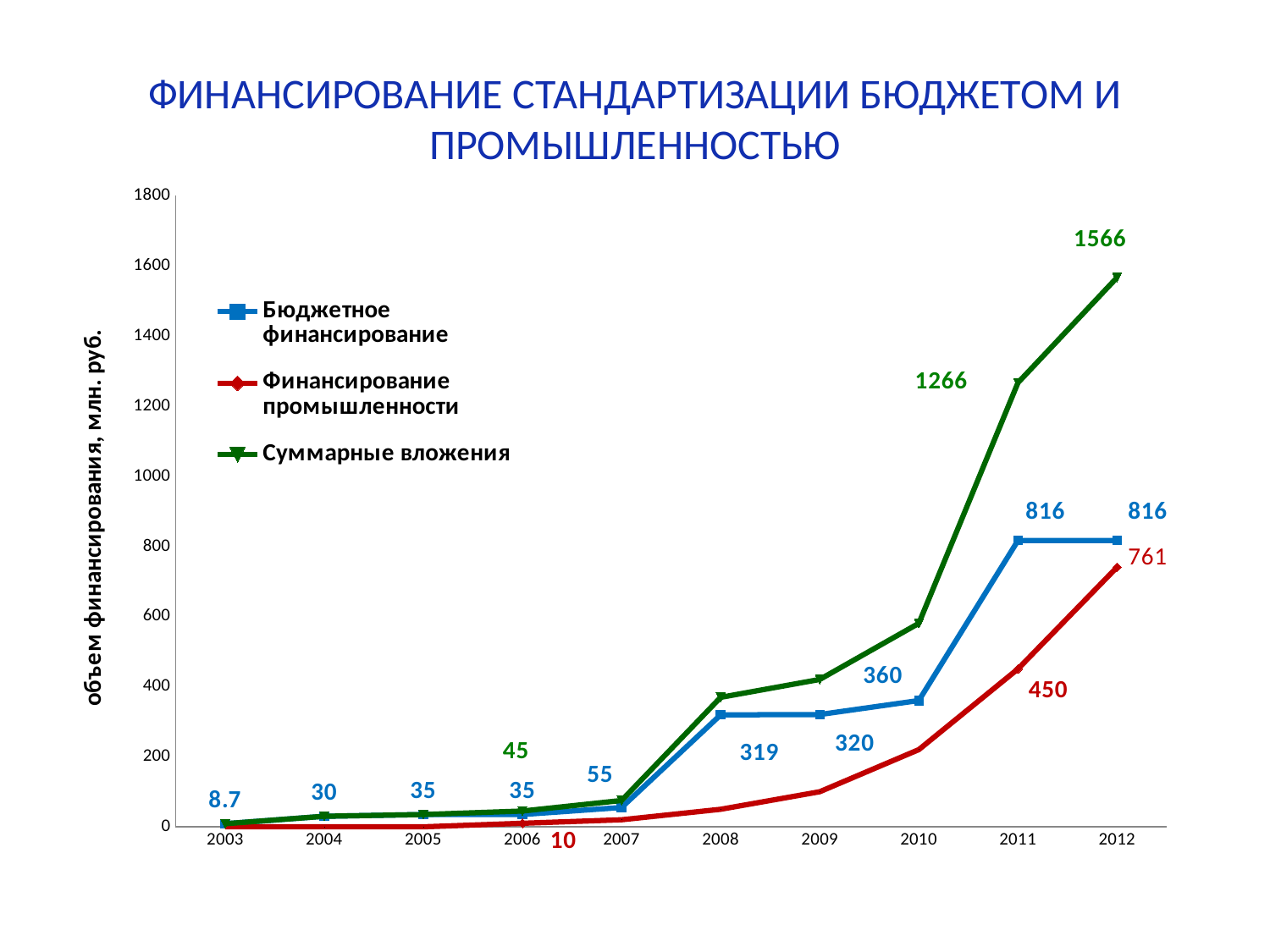
How many series does the legend list? 3 What is the value of Суммарные вложения in 2012? 1566 What is the difference between Бюджетное финансирование and Финансирование промышленности in 2012? 55 Is the value of Суммарные вложения in 2010 greater or less than 400? greater By how much did Бюджетное финансирование increase from 2010 to 2011? 456 How many years are plotted along the x axis? 10 What is the value of Финансирование промышленности in 2011? 450 In which year is Суммарные вложения highest? 2012 What is the value of Бюджетное финансирование in 2012? 816 In 2012, which is larger: Бюджетное финансирование or Финансирование промышленности? Бюджетное финансирование What is the value of Бюджетное финансирование in 2003? 8.7 What kind of chart is shown on the slide? line chart